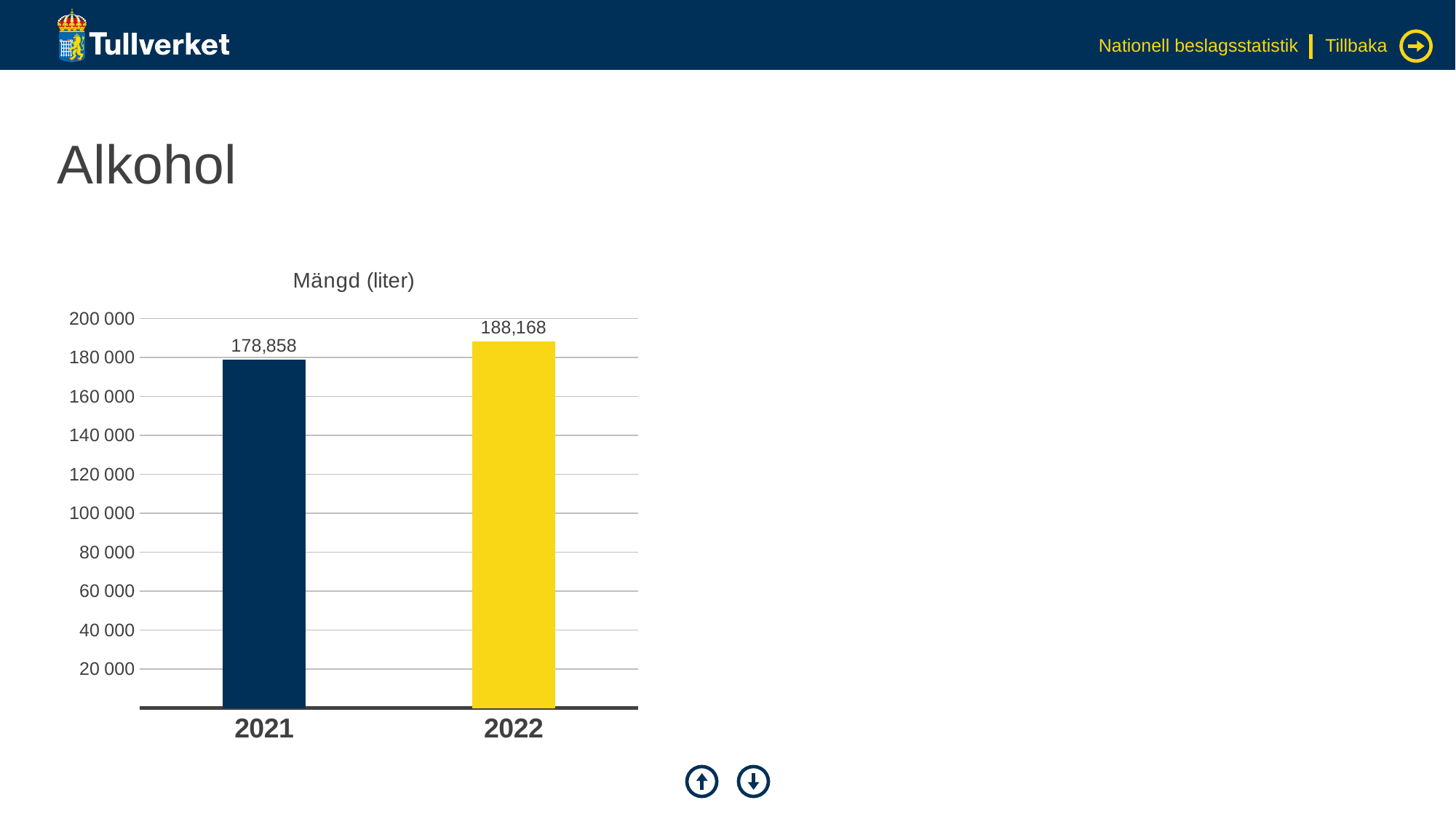
What is the value for 2021 in the Mängd (liter) chart? 178,858 Is the value for 2021 greater or less than 180 000? less Which year has the highest value in the Mängd (liter) chart? 2022 Is the value for 2022 greater or less than 180 000? greater What is the title of the chart on the slide? Mängd (liter) What is the difference between the 2022 and 2021 values in the Mängd (liter) chart? 9,310 Which is larger in the Mängd (liter) chart, the value for 2021 or for 2022? 2022 What is the value for 2022 in the Mängd (liter) chart? 188,168 Which year has the lowest value in the Mängd (liter) chart? 2021 Do the values rise or fall from 2021 to 2022? rise What kind of chart is shown on the slide? bar chart How many years are shown on the x axis of the chart? 2